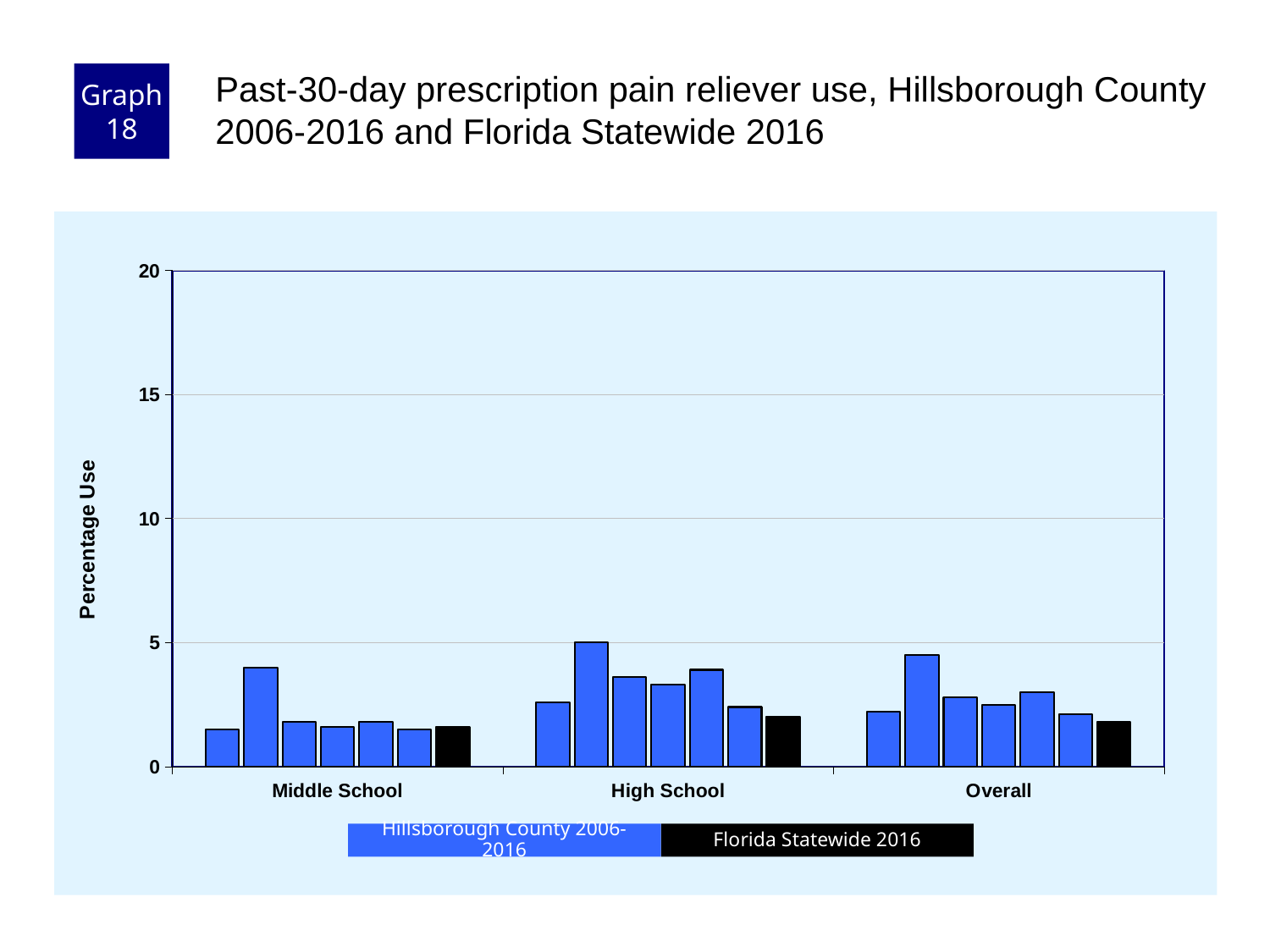
Which is larger: the Florida Statewide 2016 value for High School or for Middle School? High School What kind of chart is shown on the slide? bar chart Which category group contains the tallest bar on the chart? High School Is the Florida Statewide 2016 value for High School greater or less than 5? less How many school-level categories are shown on the x axis? 3 Is the Florida Statewide 2016 value for Middle School greater or less than 5? less How many series does the legend list? 2 What is the highest value shown on the y axis? 20 What is the label of the y axis? Percentage Use Is the tallest Hillsborough County bar in the Middle School group greater or less than 5? less